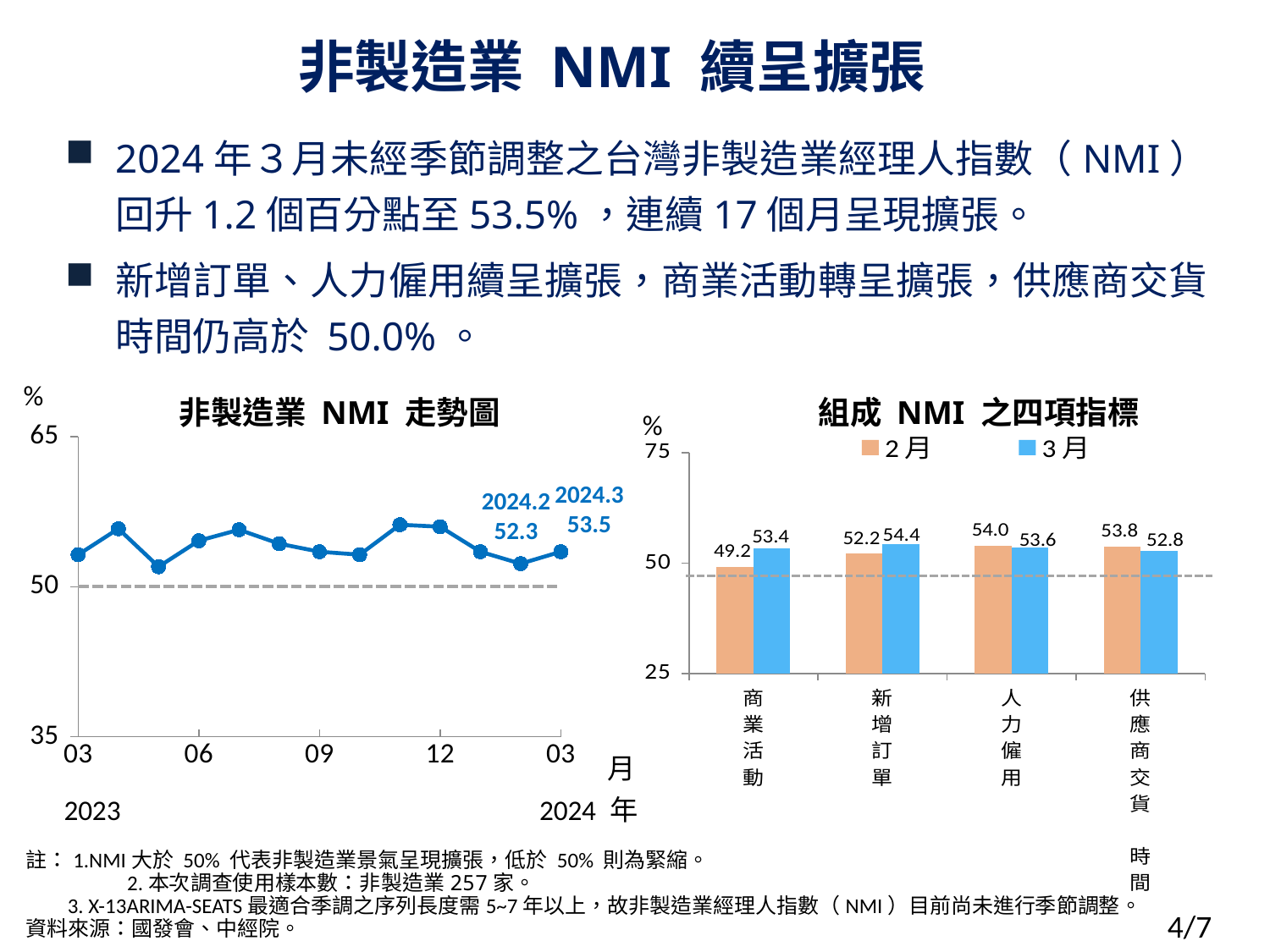
In the chart titled 非製造業 NMI 走勢圖, what is the value labelled for 2024.2? 52.3 In the chart titled 組成 NMI 之四項指標, is the 2月 value for 供應商交貨時間 larger or smaller than its 3月 value? larger In the chart titled 組成 NMI 之四項指標, which category has the highest 3月 value? 新增訂單 In the chart titled 組成 NMI 之四項指標, what is the difference between the 3月 and 2月 values for 商業活動? 4.2 In the chart titled 非製造業 NMI 走勢圖, what is the value labelled for 2024.3? 53.5 What kind of chart is the 非製造業 NMI 走勢圖 on the left? line chart In the chart titled 組成 NMI 之四項指標, which category has the lowest 2月 value? 商業活動 How many categories are shown in the chart titled 組成 NMI 之四項指標? 4 In the chart titled 組成 NMI 之四項指標, what is the 2月 value for 人力僱用? 54.0 How many series does the legend of the chart titled 組成 NMI 之四項指標 list? 2 In the chart titled 非製造業 NMI 走勢圖, what is the difference between the 2024.3 and 2024.2 values? 1.2 In the chart titled 組成 NMI 之四項指標, what is the 3月 value for 商業活動? 53.4